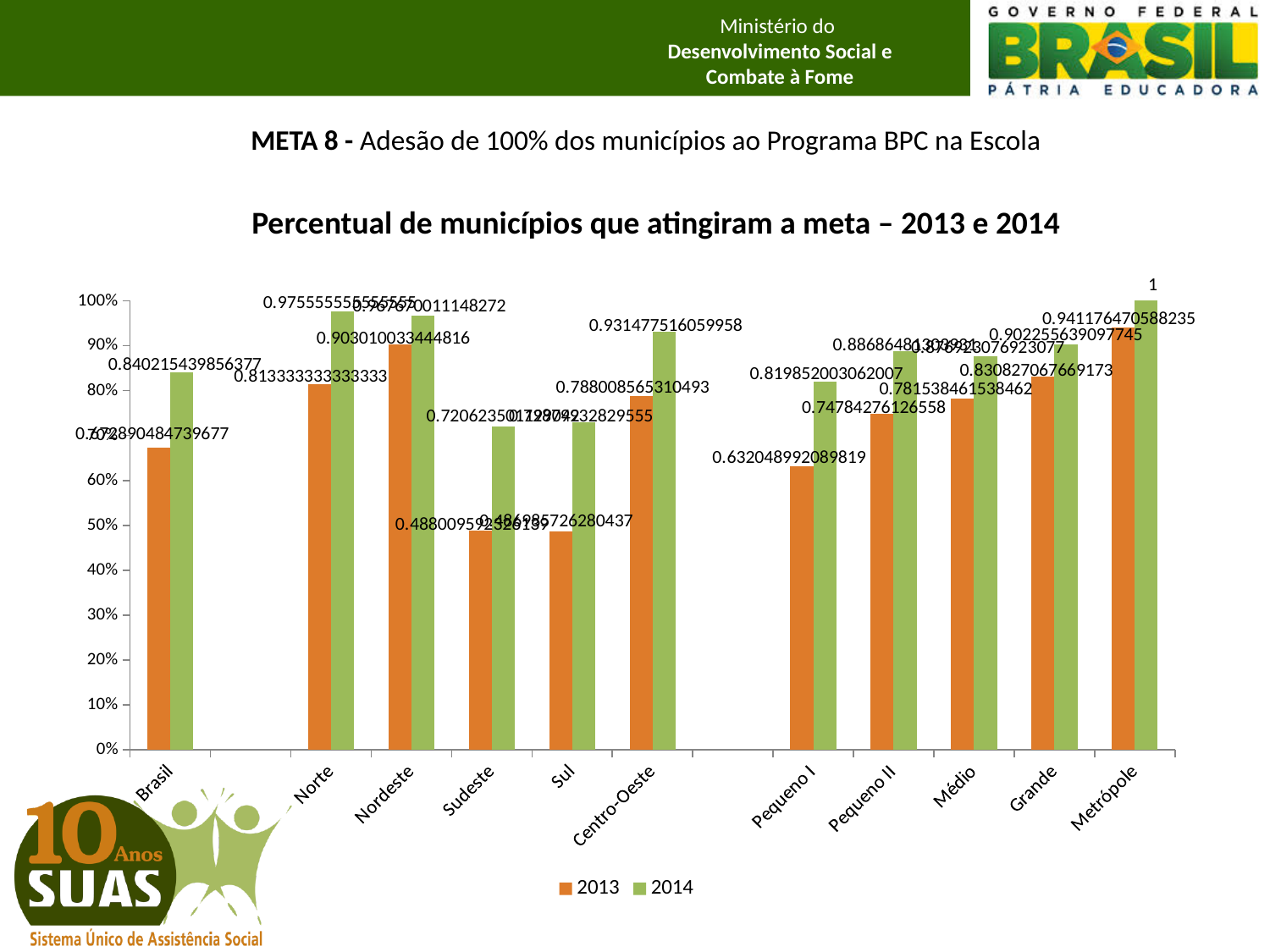
Which category has the highest 2014 value? Metrópole Which is larger for 2013: Norte or Nordeste? Nordeste Do the 2014 values rise or fall from Pequeno I to Metrópole? rise What is the 2013 value for Grande? 0.830827067669173 What kind of chart is shown on the slide? bar chart What is the 2014 value for Centro-Oeste? 0.931477516059958 How many categories are shown on the x axis? 11 What is the 2013 value for Pequeno I? 0.632048992089819 Is the 2013 value for Sudeste greater or less than 50%? less Which category has the lowest 2014 value? Sudeste How many series does the legend list? 2 What is the 2014 value for Metrópole? 1